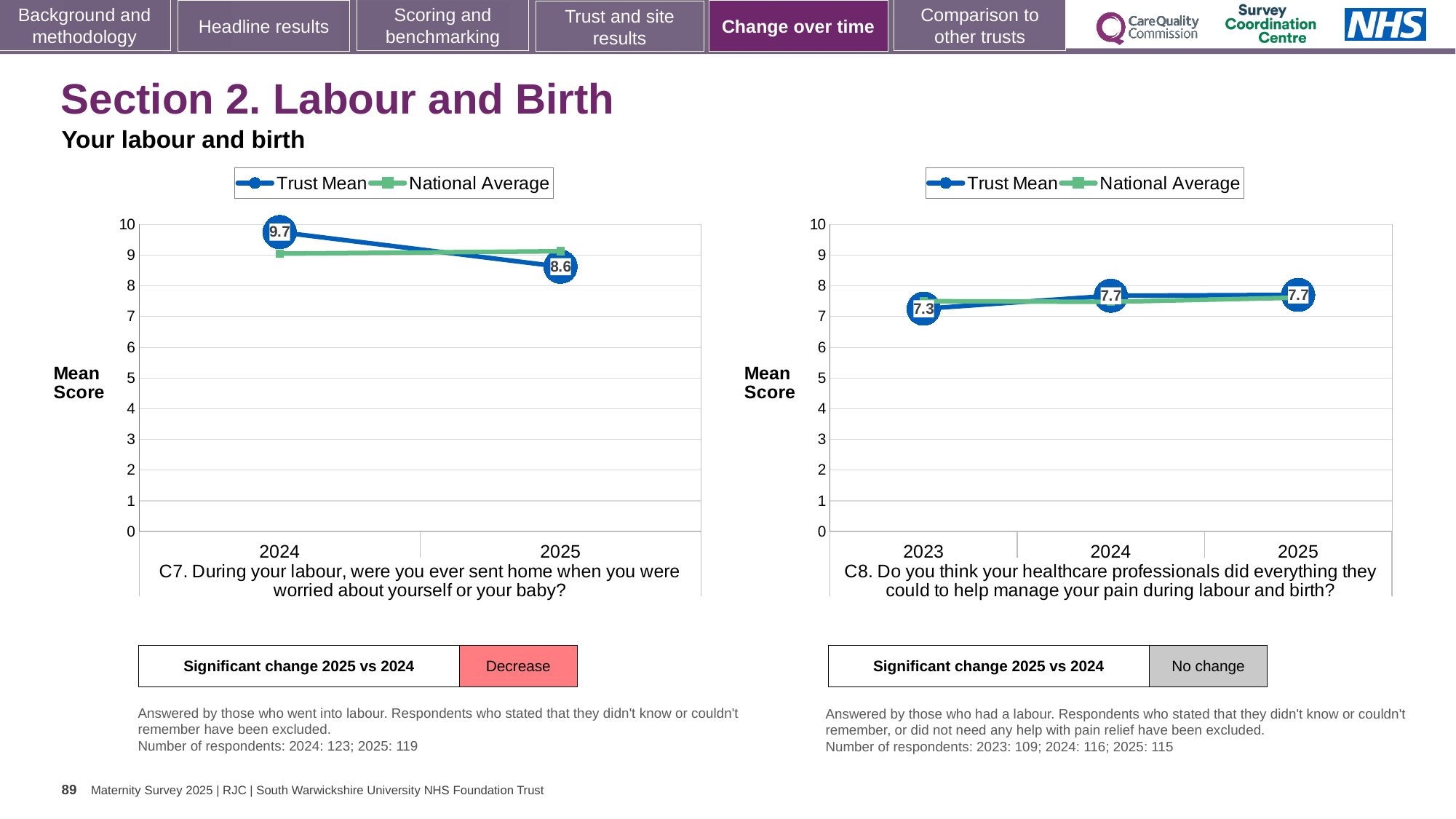
In the C8 chart (right), what is the Trust Mean for 2025? 7.7 In the C7 chart (left), what is the Trust Mean for 2025? 8.6 In the C7 chart (left), does the Trust Mean rise or fall from 2024 to 2025? fall In the C8 chart (right), which year has the lowest Trust Mean? 2023 In the C7 chart (left), is the National Average for 2024 greater or less than 8? greater In the C7 chart (left), by how much did the Trust Mean change from 2024 to 2025? 1.1 In the C7 chart (left), what is the Trust Mean for 2024? 9.7 How many series does the legend of the C7 chart (left) list? 2 What kind of chart is the C8 chart (right)? line chart In the C8 chart (right), how many years are plotted on the x axis? 3 In the C8 chart (right), what is the Trust Mean for 2023? 7.3 In the C8 chart (right), is the National Average for 2024 greater or less than 7? greater